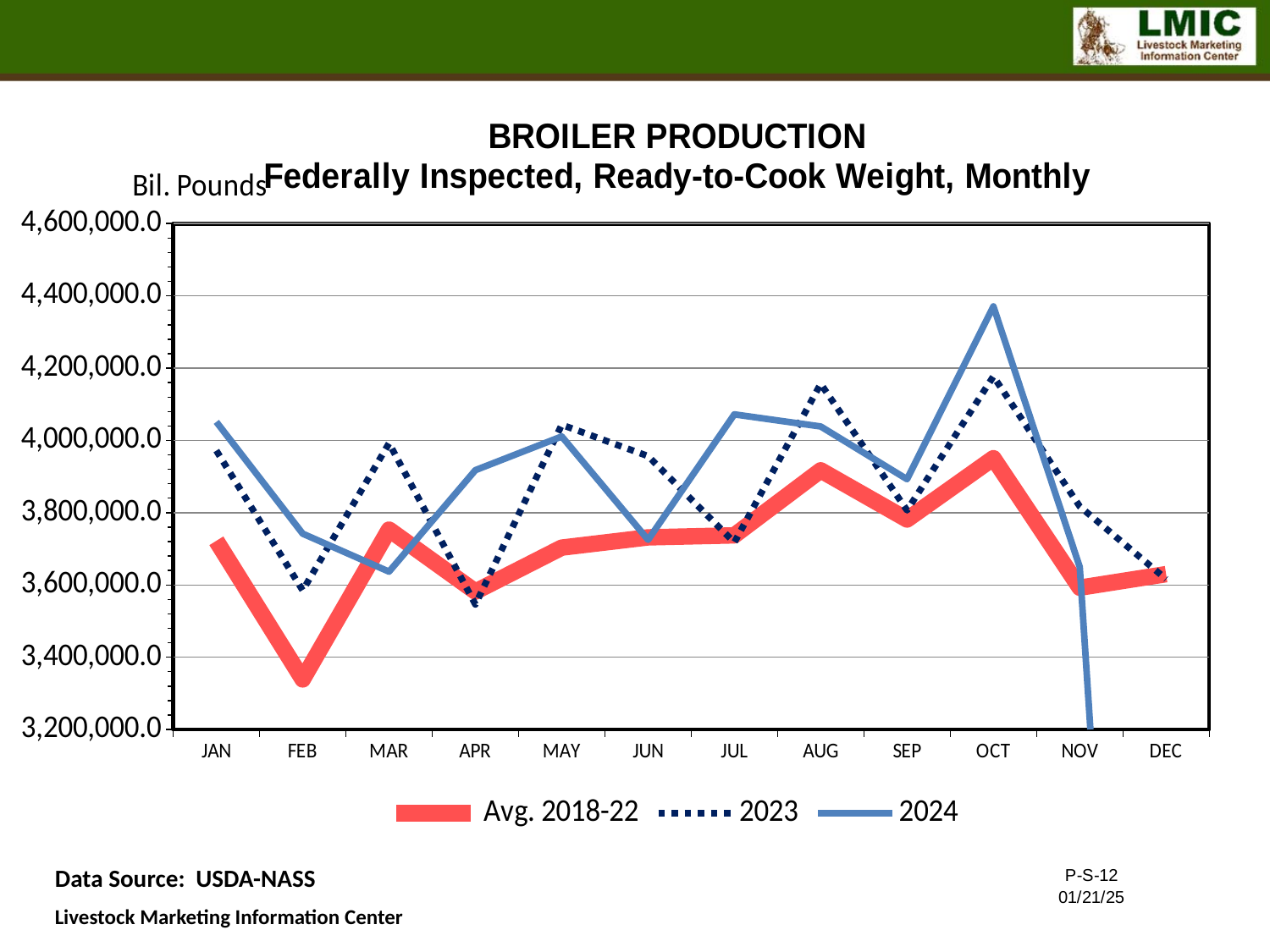
What unit label is shown above the y axis? Bil. Pounds Is the 2024 value for OCT greater or less than 4,200,000.0? greater In OCT, which series has the larger value, 2023 or 2024? 2024 How many series does the legend list? 3 Is the 2023 value for AUG greater or less than 4,000,000.0? greater How many months are shown along the x axis? 12 Is the Avg. 2018-22 value for FEB greater or less than 3,400,000.0? less Does the Avg. 2018-22 series rise or fall from OCT to NOV? fall In which month does the 2024 series reach its highest value? OCT In MAR, which series has the larger value, 2023 or 2024? 2023 In which month is the Avg. 2018-22 series at its lowest value? FEB What kind of chart is shown on the slide? line chart